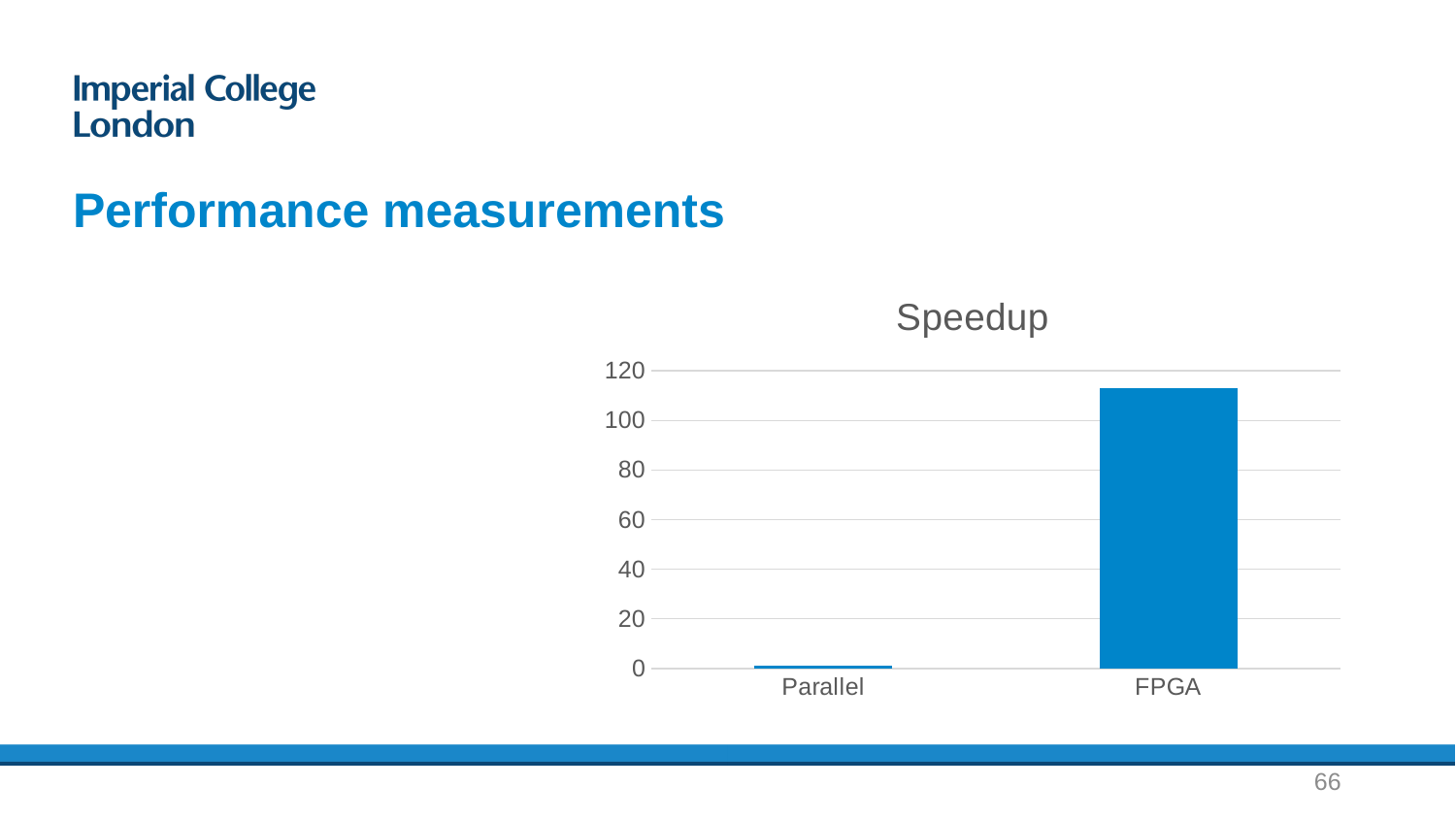
What is the highest value shown on the y axis of the Speedup chart? 120 Which category has the highest speedup? FPGA What is the title of the chart? Speedup What kind of chart is shown on the slide? bar chart Is the speedup for FPGA greater or less than 120? less Do the values rise or fall from Parallel to FPGA along the x axis? rise How many categories are shown on the x axis of the Speedup chart? 2 Is the speedup for Parallel greater or less than 20? less Which has a larger speedup, Parallel or FPGA? FPGA Which category has the lowest speedup? Parallel Is the speedup for FPGA greater or less than 100? greater